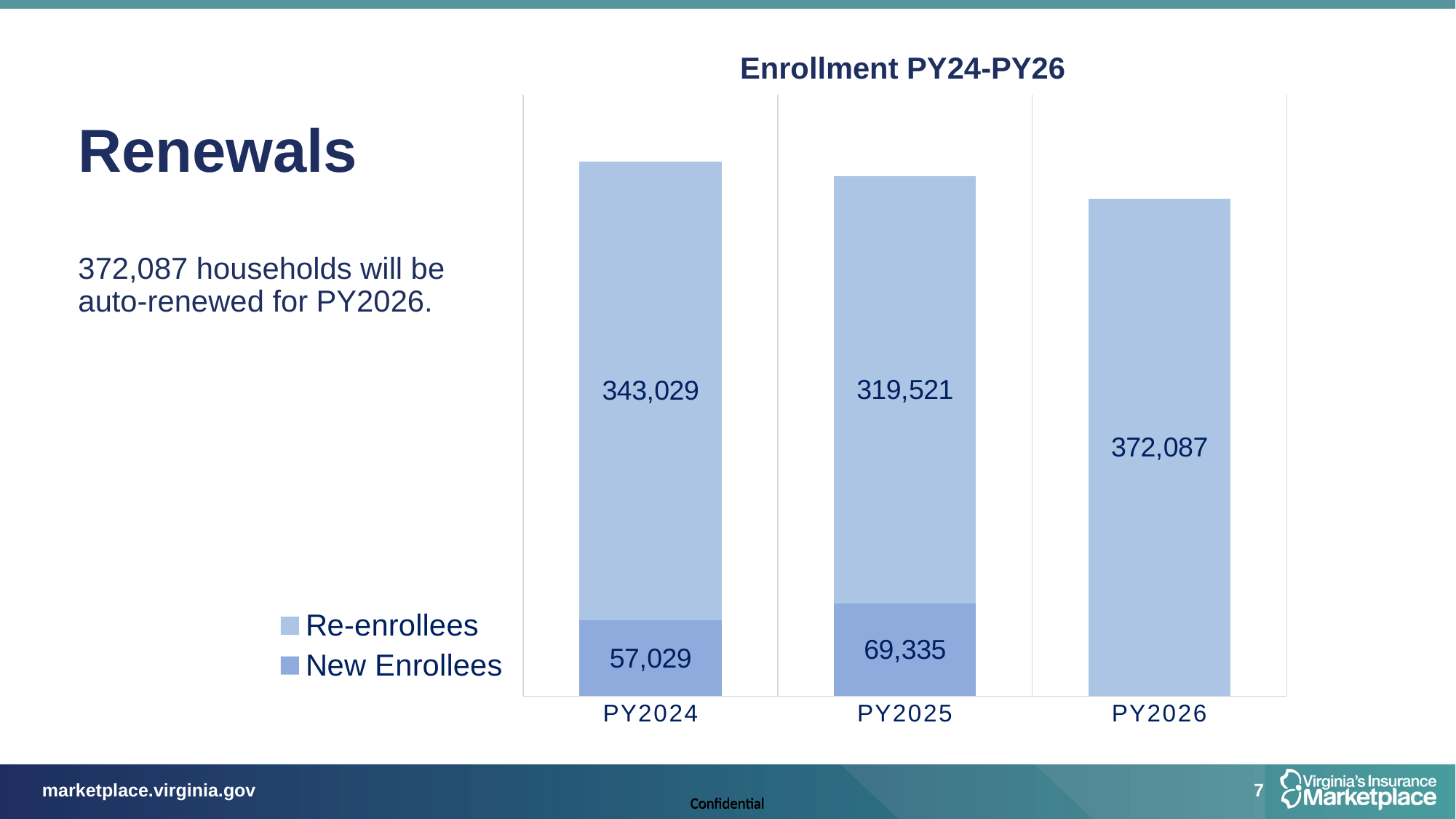
Which is larger: New Enrollees in PY2024 or New Enrollees in PY2025? PY2025 How many series does the legend list? 2 What is the value for Re-enrollees in PY2024? 343,029 What is the total enrollment shown for the PY2025 bar? 388,856 What is the difference between Re-enrollees in PY2024 and PY2025? 23,508 Which plan year has the lowest number of Re-enrollees? PY2025 What is the value for Re-enrollees in PY2026? 372,087 What is the value for New Enrollees in PY2025? 69,335 What is the total enrollment shown for the PY2024 bar? 400,058 Which plan year has the highest number of Re-enrollees? PY2026 How many plan years are shown on the x axis? 3 What is the value for New Enrollees in PY2024? 57,029